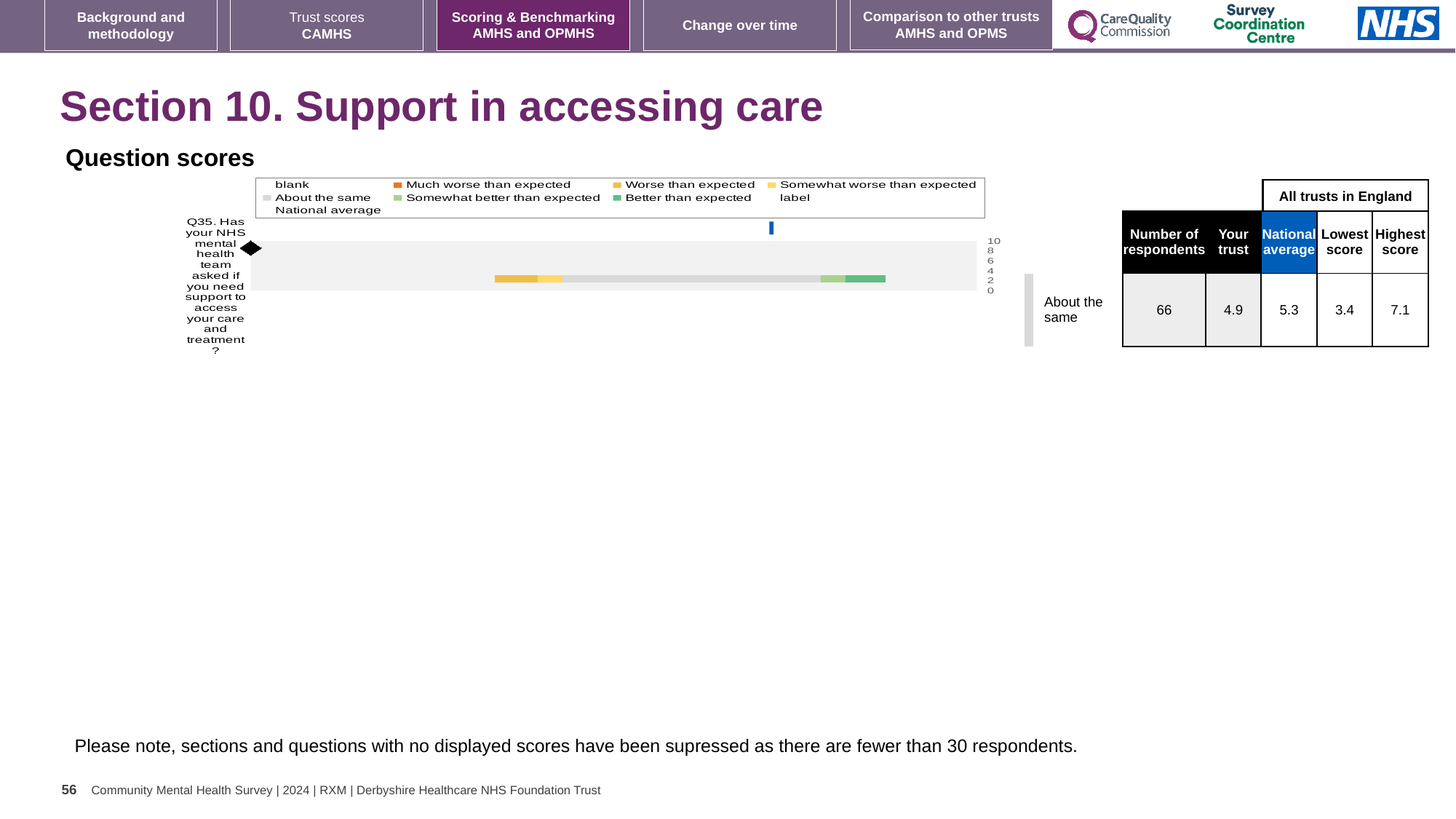
How many respondents answered Q35? 66 What is the national average score for Q35? 5.3 Which question is shown in the Question scores chart? Q35. Has your NHS mental health team asked if you need support to access your care and treatment? What benchmark category is the trust's Q35 score placed in? About the same How many questions are plotted in the Question scores chart? 1 What is the trust's score for Q35? 4.9 What is the difference between the national average and the trust's score for Q35? 0.4 What is the highest score among all trusts in England for Q35? 7.1 What is the lowest score among all trusts in England for Q35? 3.4 What is the difference between the highest and lowest scores for Q35 across all trusts in England? 3.7 What kind of chart is used to show the Q35 question score? bar chart Which is larger for Q35, the trust's score or the national average? National average